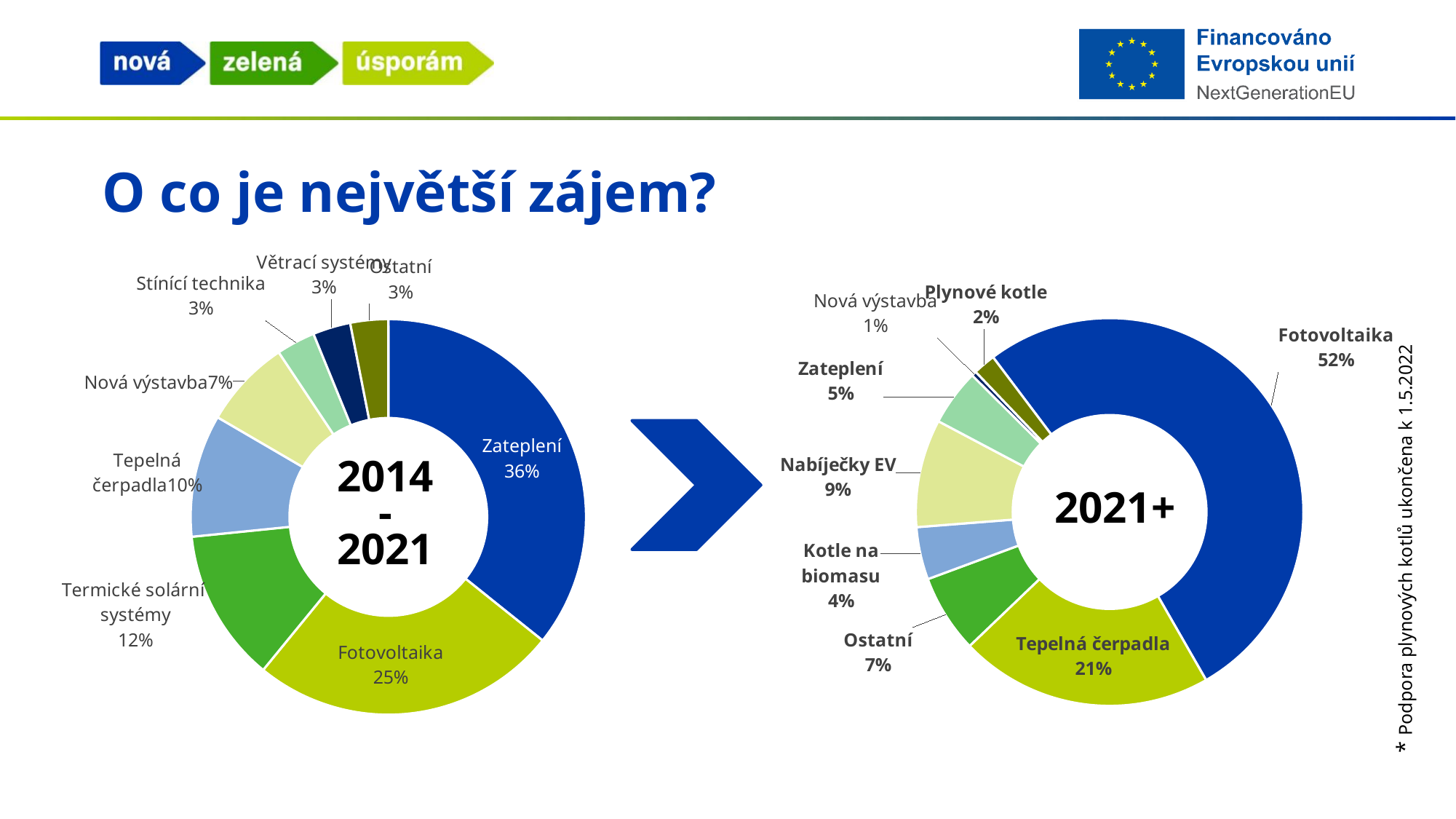
In the right donut chart (2021+), what share does Fotovoltaika have? 52% In the right donut chart (2021+), what is the difference between the shares of Fotovoltaika and Tepelná čerpadla? 31 percentage points In the left donut chart (2014-2021), what share does Zateplení have? 36% In the left donut chart (2014-2021), what is the combined share of Zateplení and Fotovoltaika? 61% What type of chart is used on the left side of the slide (2014-2021)? Donut (pie) chart In the left donut chart (2014-2021), which category has the largest share? Zateplení How many categories are shown in the right donut chart (2021+)? 8 In the right donut chart (2021+), which category has the smallest share? Nová výstavba In the left donut chart (2014-2021), which is larger: Termické solární systémy or Tepelná čerpadla? Termické solární systémy What is the label shown in the centre of the right donut chart? 2021+ In the right donut chart (2021+), what share do Nabíječky EV have? 9% In the left donut chart (2014-2021), what share does Fotovoltaika have? 25%